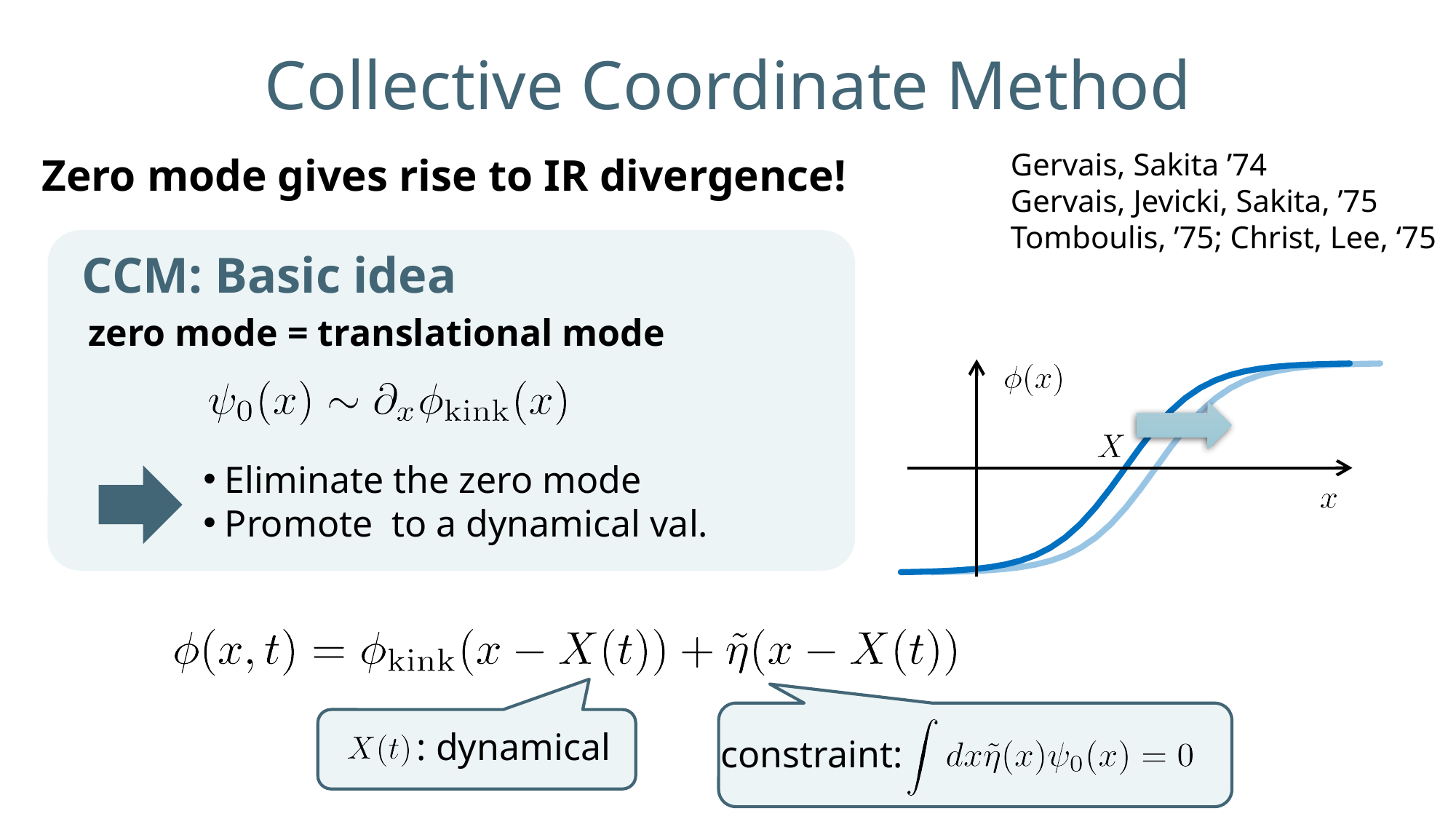
What is the label on the horizontal axis of the plot on the right? x What kind of chart is the plot on the right side of the slide? line chart In the plot on the right, does the curve rise or fall as x increases? rise What is the label on the vertical axis of the plot on the right? φ(x) How many curves are drawn in the plot on the right? 2